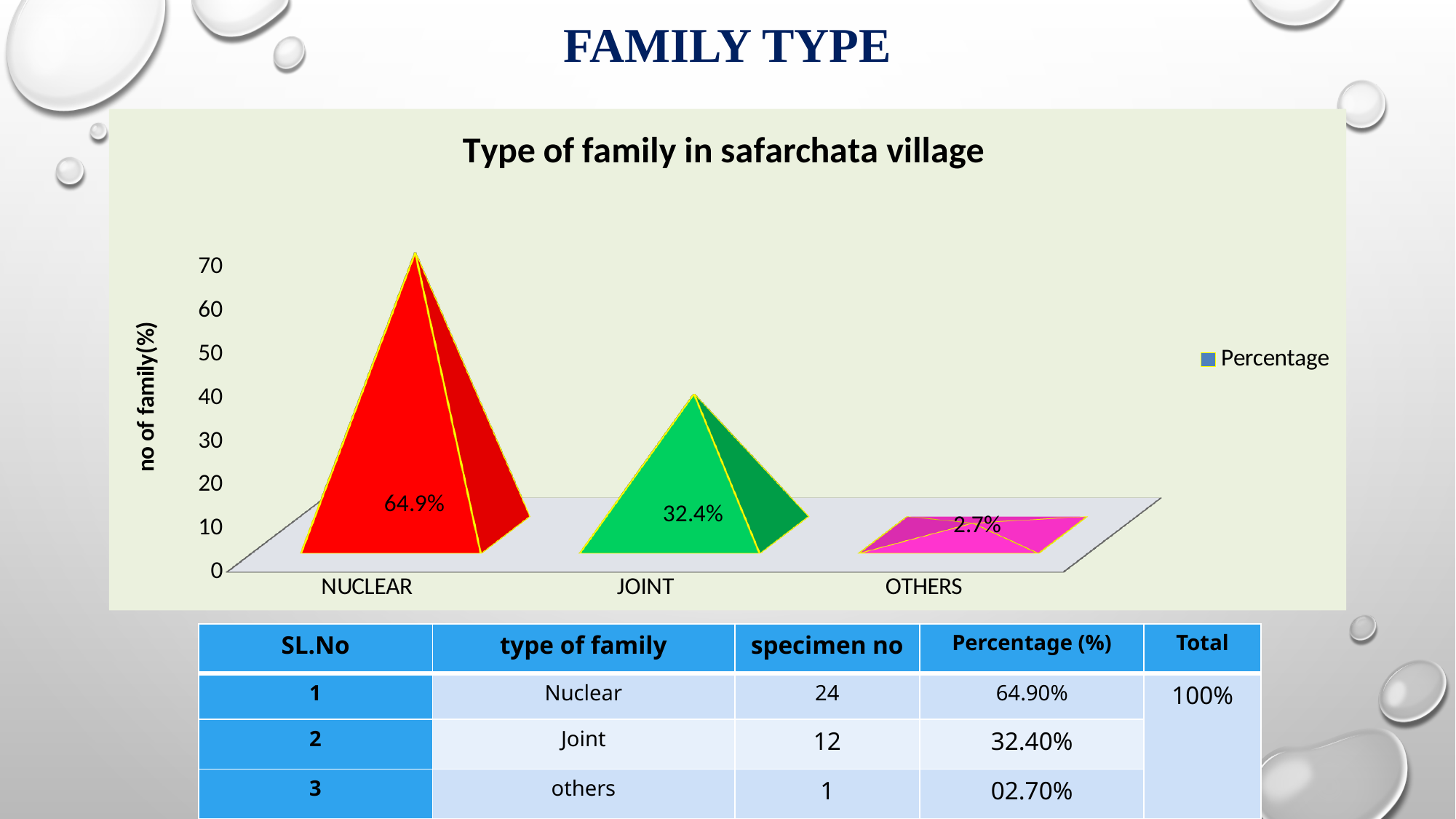
How many family type categories are shown on the x axis of the chart? 3 Which family type has the highest percentage in the chart? NUCLEAR What is the value for OTHERS in the chart? 2.7% What is the difference between the values for JOINT and OTHERS? 29.7% Is the value for NUCLEAR greater or less than 60? greater How many series does the chart legend list? 1 Which family type has the lowest percentage in the chart? OTHERS What is the value for NUCLEAR in the chart? 64.9% What is the title of the chart? Type of family in safarchata village What is the value for JOINT in the chart? 32.4% Which is larger, the value for JOINT or the value for OTHERS? JOINT What is the difference between the values for NUCLEAR and JOINT? 32.5%